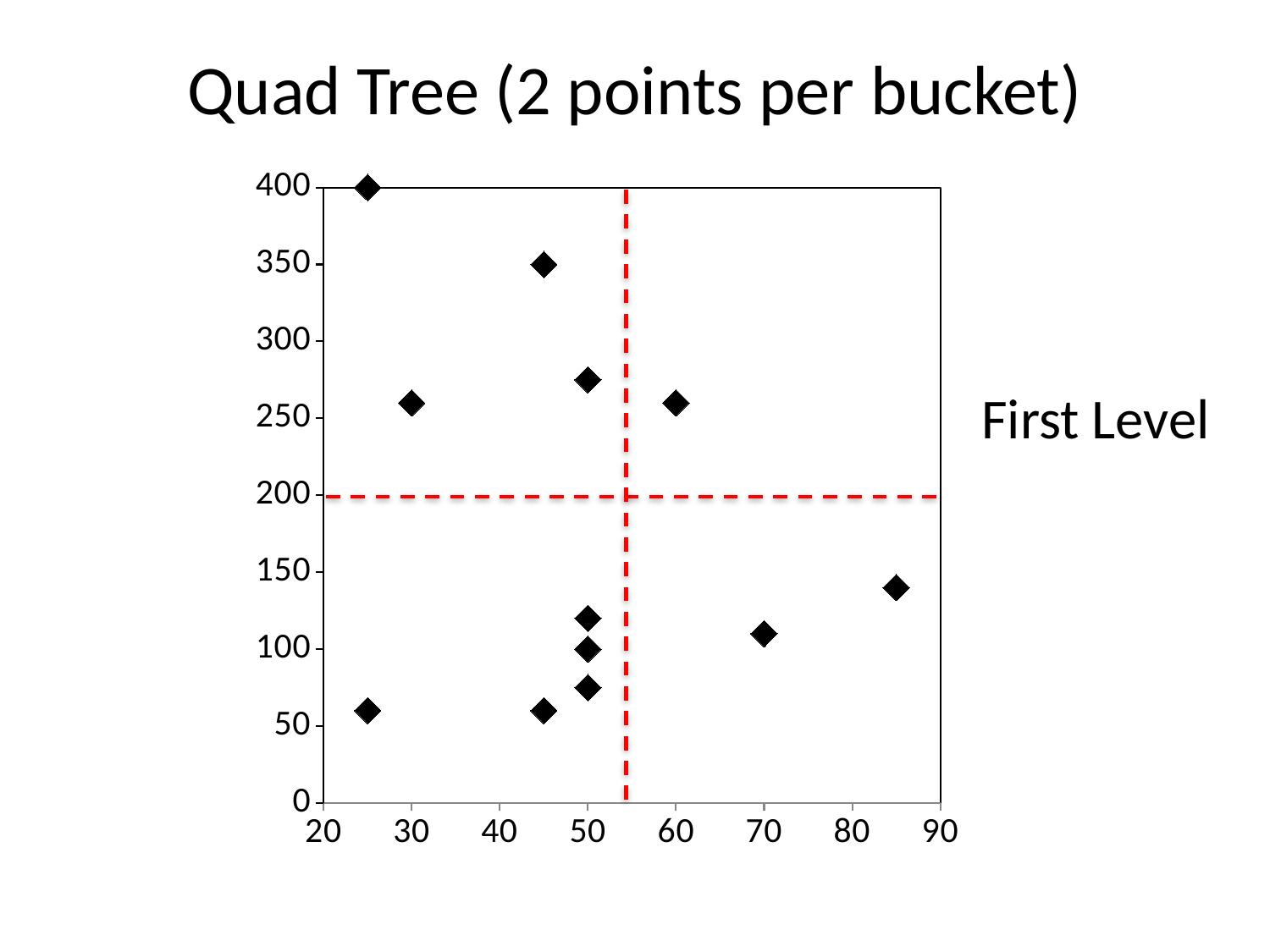
What colour are the dashed lines that divide the chart into four regions? red What is the title of the chart on the slide? Quad Tree (2 points per bucket) Is the y value of the point near x = 30 in the upper half greater or less than 200? greater How many data points are plotted on the chart? 12 What kind of chart is shown on the slide? scatter chart How many points lie to the right of the vertical red dashed line? 3 What is the highest y-axis value reached by any point on the chart? 400 Is the y value of the point near x = 70 greater or less than 150? less How many points lie above the horizontal red dashed line? 5 What is the maximum value shown on the x axis? 90 Is the y value of the rightmost point (near x = 85) greater or less than 200? less In the upper half of the chart, which point has the higher y value: the one near x = 45 or the one near x = 50? the one near x = 45